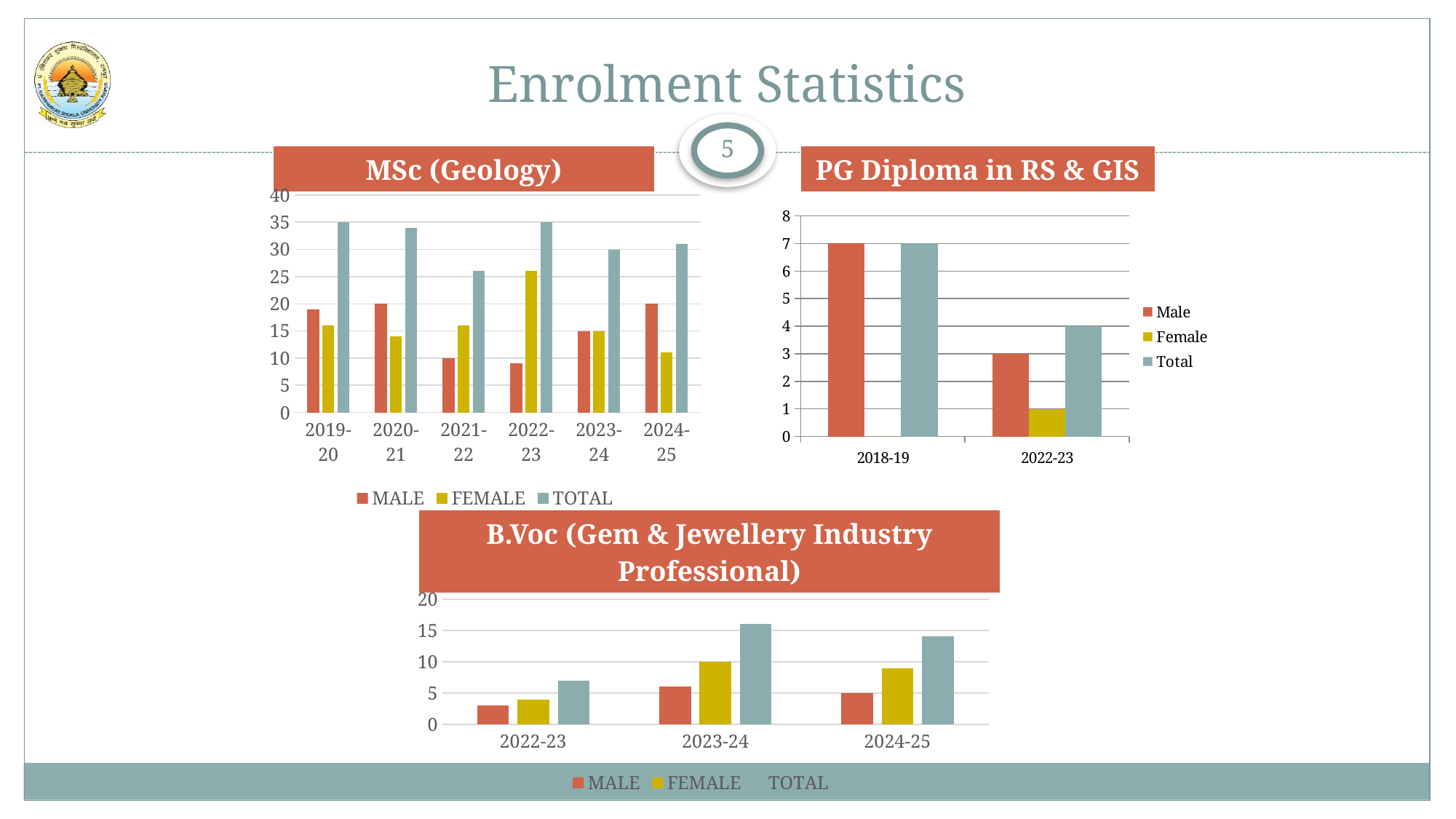
In the MSc (Geology) chart, how many academic years are shown on the x axis? 6 In the PG Diploma in RS & GIS chart, what is the Female value for 2022-23? 1 In the PG Diploma in RS & GIS chart, what is the difference between the Male values for 2018-19 and 2022-23? 4 In the MSc (Geology) chart, which is larger for 2022-23, the MALE value or the FEMALE value? FEMALE In the B.Voc (Gem & Jewellery Industry Professional) chart, what is the FEMALE value for 2023-24? 10 In the MSc (Geology) chart, how many series does the legend list? 3 In the B.Voc (Gem & Jewellery Industry Professional) chart, which year has the highest TOTAL value? 2023-24 In the PG Diploma in RS & GIS chart, what is the Total value for 2022-23? 4 In the MSc (Geology) chart, what is the MALE value for 2021-22? 10 In the MSc (Geology) chart, what is the TOTAL value for 2023-24? 30 In the MSc (Geology) chart, is the FEMALE value for 2022-23 greater or less than 25? greater In the PG Diploma in RS & GIS chart, what is the Male value for 2018-19? 7